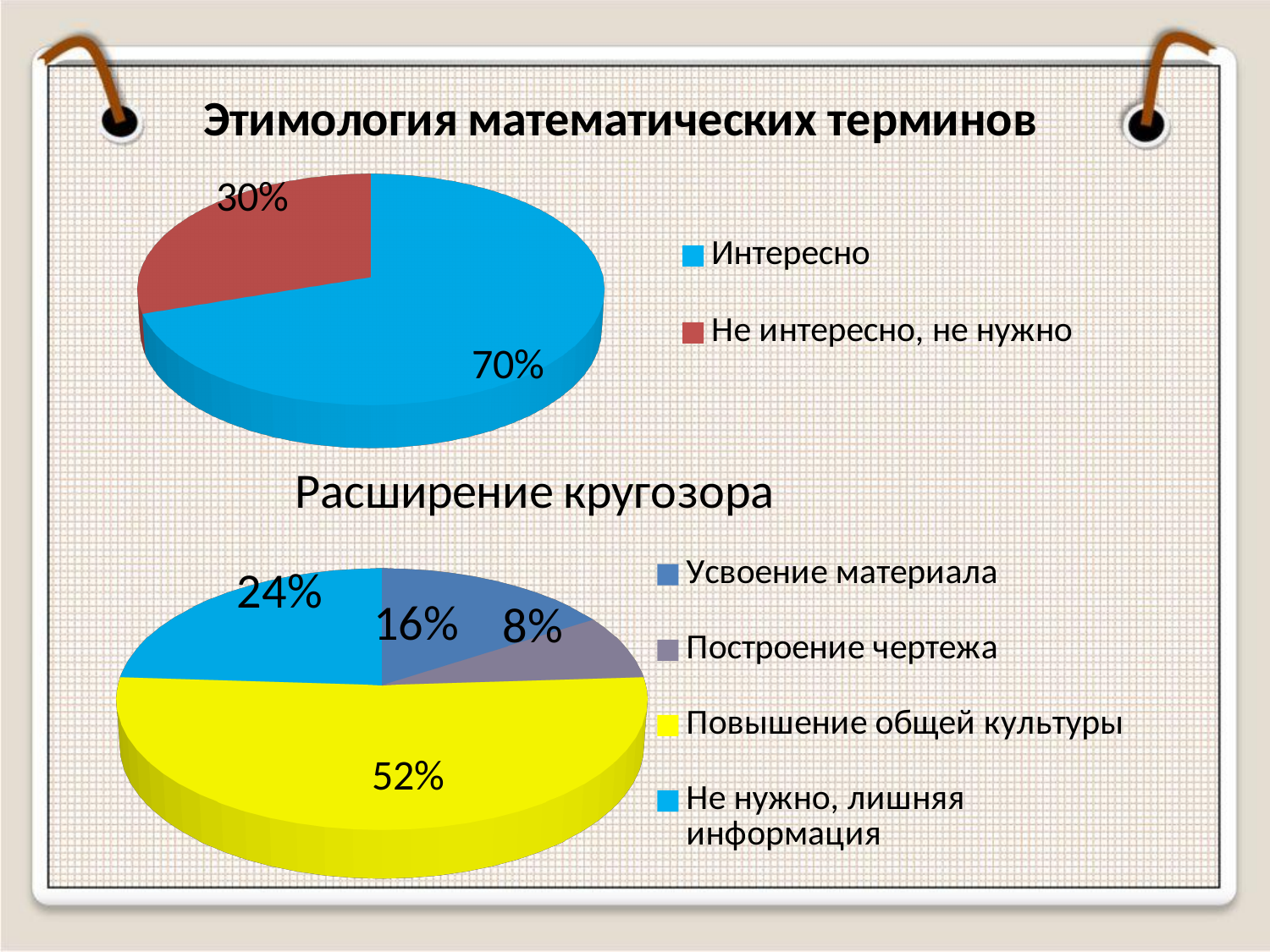
In the chart titled "Расширение кругозора", what share is labelled for "Не нужно, лишняя информация"? 24% In the chart titled "Расширение кругозора", what share is labelled for "Повышение общей культуры"? 52% In the chart titled "Этимология математических терминов", what share is labelled for "Интересно"? 70% In the chart titled "Этимология математических терминов", what share is labelled for "Не интересно, не нужно"? 30% What kind of chart is the chart titled "Расширение кругозора"? Pie chart In the chart titled "Расширение кругозора", what share is labelled for "Построение чертежа"? 8% How many categories does the legend of the chart titled "Расширение кругозора" list? 4 In the chart titled "Расширение кругозора", which category has the smallest slice? Построение чертежа In the chart titled "Этимология математических терминов", what is the difference between the "Интересно" and "Не интересно, не нужно" shares? 40% In the chart titled "Расширение кругозора", what colour is the slice for "Повышение общей культуры"? Yellow In the chart titled "Этимология математических терминов", which category has the largest slice? Интересно In the chart titled "Расширение кругозора", which is larger: "Усвоение материала" or "Не нужно, лишняя информация"? Не нужно, лишняя информация